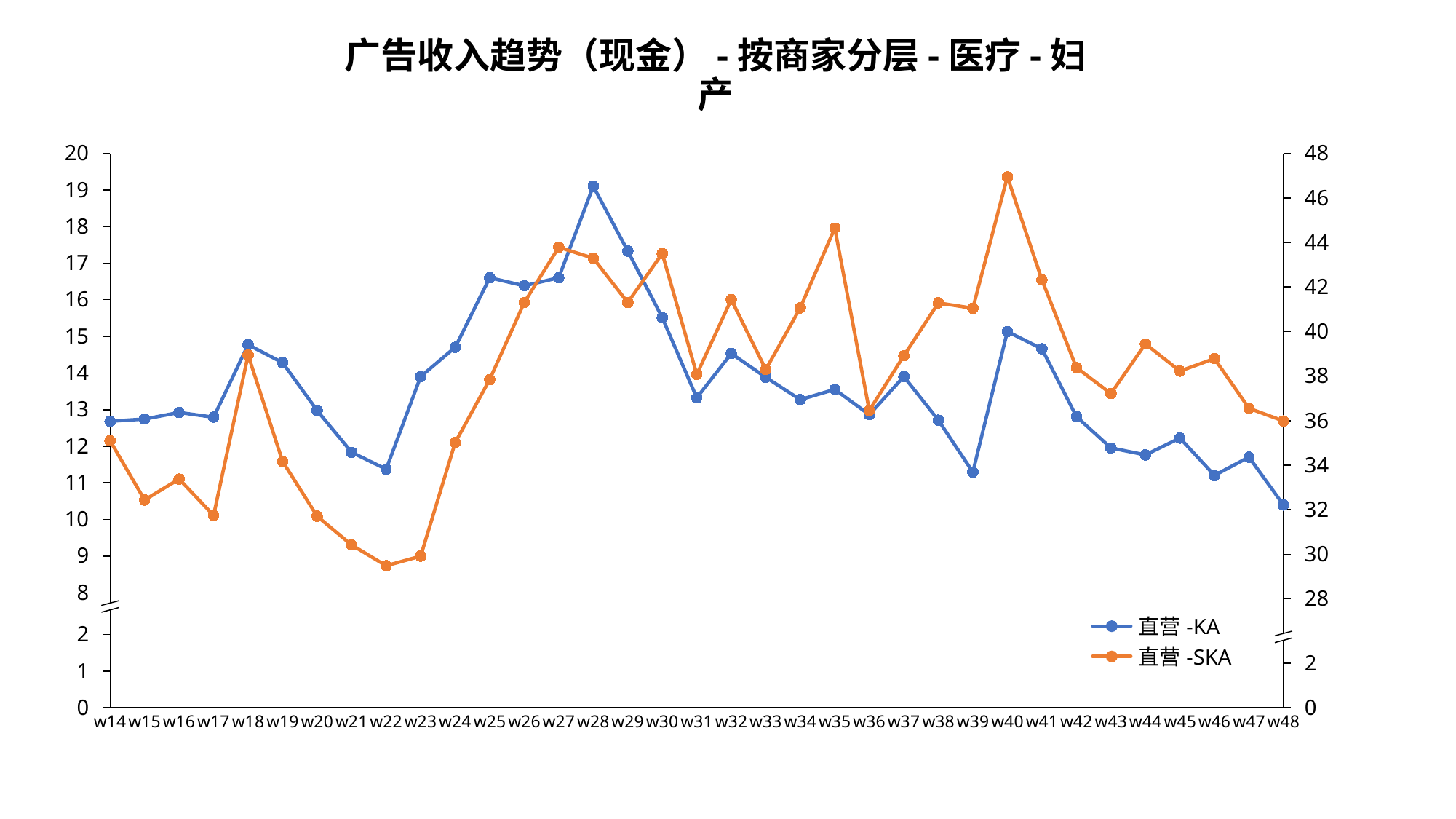
Does the 直营-SKA series rise or fall from w18 to w22? fall How many series does the legend list? 2 Is the 直营-SKA value at w17 greater or less than 34 on the right axis? less What kind of chart is shown on the slide? line chart Which colour is used for the 直营-SKA series? orange Is the 直营-SKA value at w40 greater or less than 46 on the right axis? greater In which week does the 直营-KA series reach its highest value? w28 In which week does the 直营-SKA series reach its highest value? w40 Is the 直营-KA value at w48 greater or less than 11 on the left axis? less In which week does the 直营-KA series reach its lowest value? w48 How many weeks are plotted along the x axis? 35